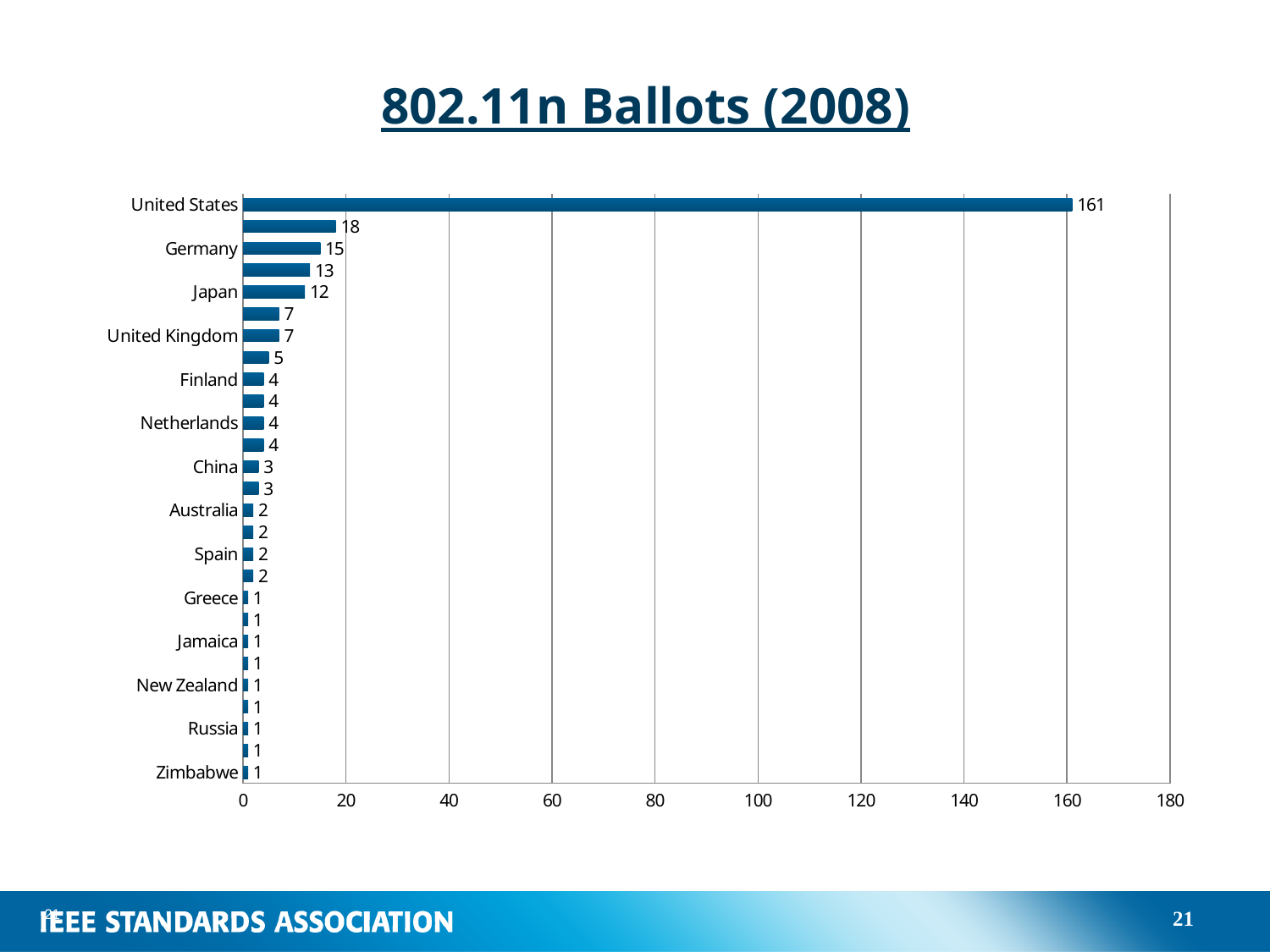
What kind of chart is shown on the slide? Bar chart What is the value for Japan? 12 What is the value for China? 3 What is the value for Finland? 4 What is the value for United States? 161 What is the value for United Kingdom? 7 Is the value for United States greater or less than 160? greater What is the title of the chart? 802.11n Ballots (2008) What is the difference between the values for United States and Germany? 146 Which category has the highest value? United States Which has a larger value, Germany or Japan? Germany What is the value for Germany? 15